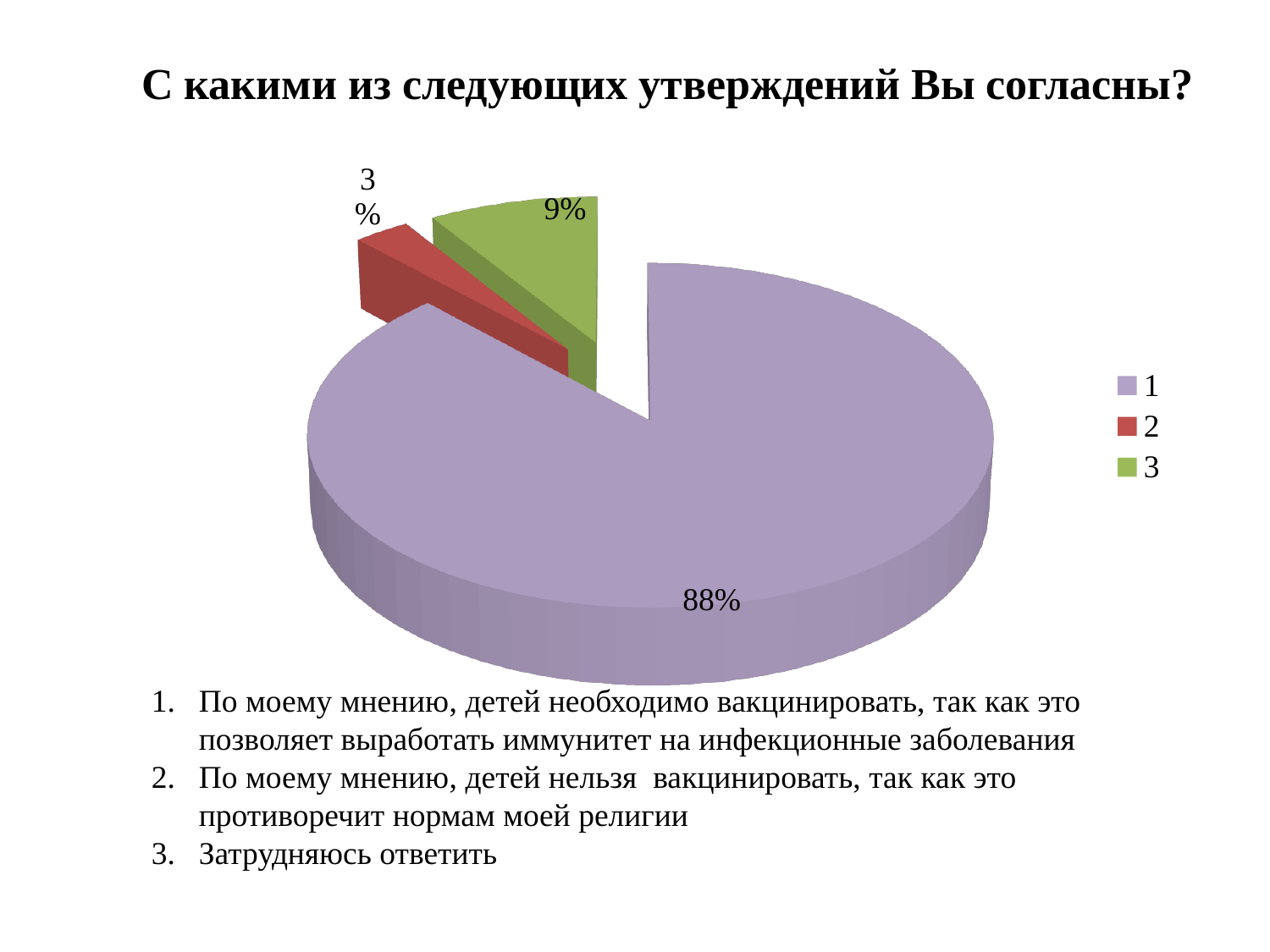
What is the value for category 1 in the pie chart? 88% What is the value for category 3 in the pie chart? 9% What is the title of the slide above the pie chart? С какими из следующих утверждений Вы согласны? Which is larger, the slice for category 3 or the slice for category 2? 3 What is the difference between the values for category 3 and category 2? 6% What kind of chart is shown on the slide? pie chart What is the difference between the values for category 1 and category 3? 79% What is the value for category 2 in the pie chart? 3% How many entries does the legend list? 3 Which category has the smallest slice of the pie chart? 2 How many slices does the pie chart have? 3 Which category has the largest slice of the pie chart? 1